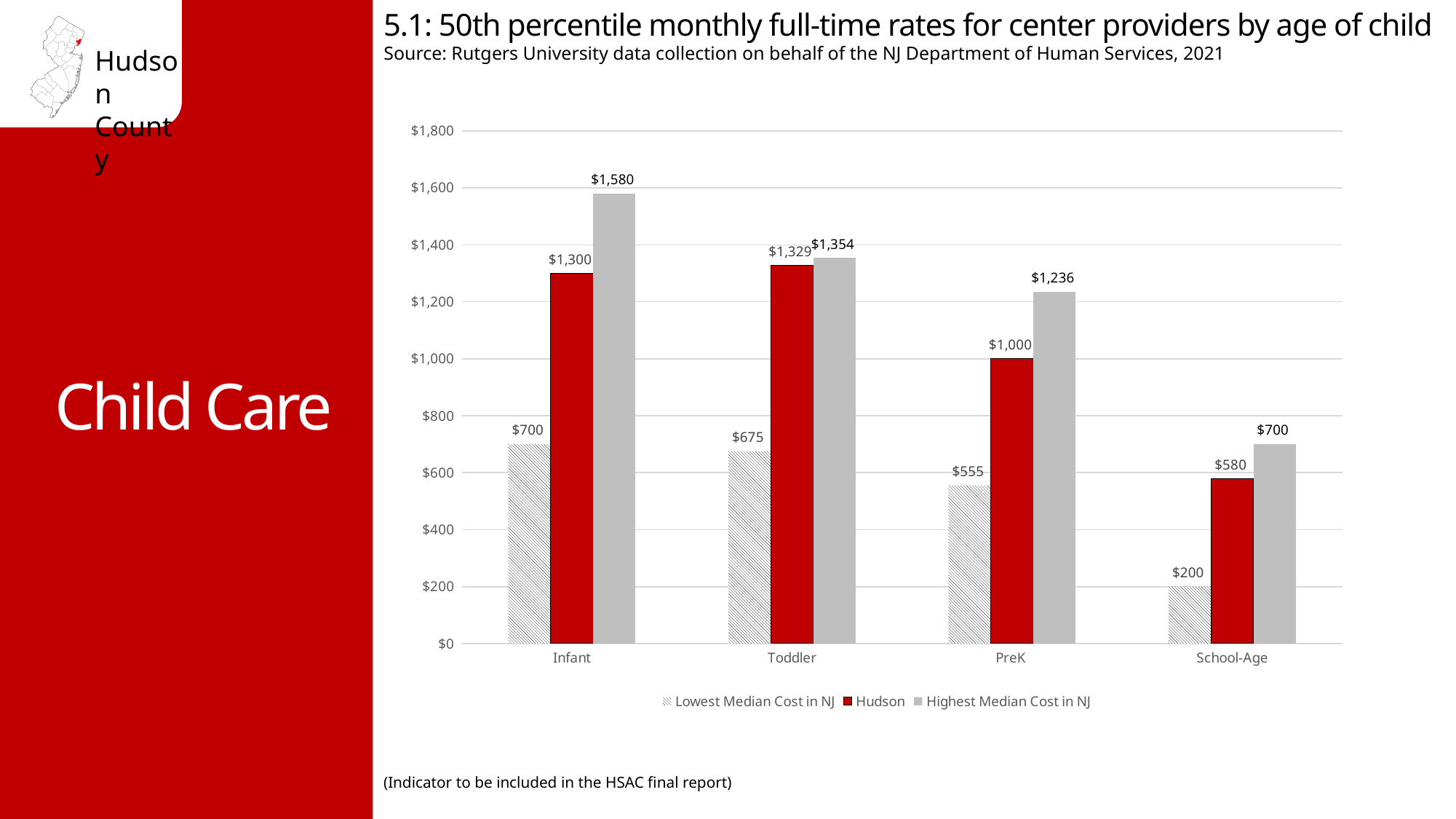
What is the Hudson value for Infant? $1,300 How many series does the legend list? 3 Is the Hudson value for Toddler greater or less than $1,200? greater What kind of chart is shown on the slide? Bar chart Which age category has the lowest Highest Median Cost in NJ value? School-Age Which series is shown in red? Hudson What is the Lowest Median Cost in NJ for School-Age? $200 Which is larger: the Hudson value for PreK or the Hudson value for School-Age? Hudson value for PreK How many age categories are shown on the x axis? 4 What is the difference between the Highest Median Cost in NJ and the Hudson value for Infant? $280 What is the Highest Median Cost in NJ for PreK? $1,236 Which age category has the highest Hudson value? Toddler